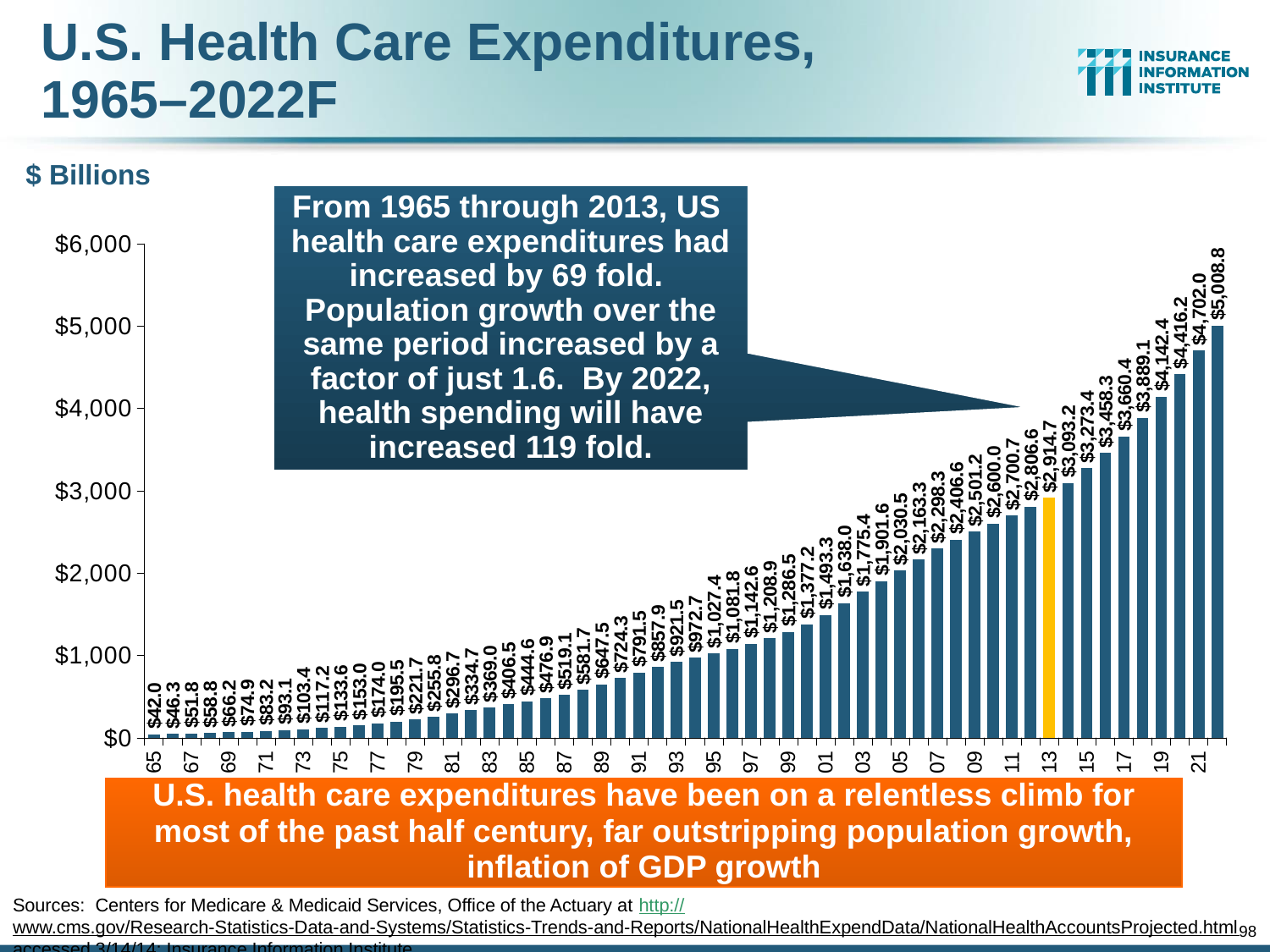
Which year's bar is highlighted in yellow rather than blue? 2013 What is the value shown for the last bar, 2022F? $5,008.8 What is the highest value shown on the chart? $5,008.8 What type of chart is shown on the slide? Bar chart In what units are the values on the chart expressed? $ Billions Do the values generally rise or fall from left to right along the x axis? Rise What is the difference between the 2022F value ($5,008.8) and the 2013 value ($2,914.7)? $2,094.1 Which year has the lowest value on the chart? 1965 What is the value shown for the year 2000 (labelled '01' is the next bar; '00' is the bar before it)? $1,377.2 What is the value shown for 2013, the bar highlighted in yellow? $2,914.7 What is the value of U.S. health care expenditures for 1965 (the first bar)? $42.0 Which is larger, the value for 1995 or the value for 2005? 2005